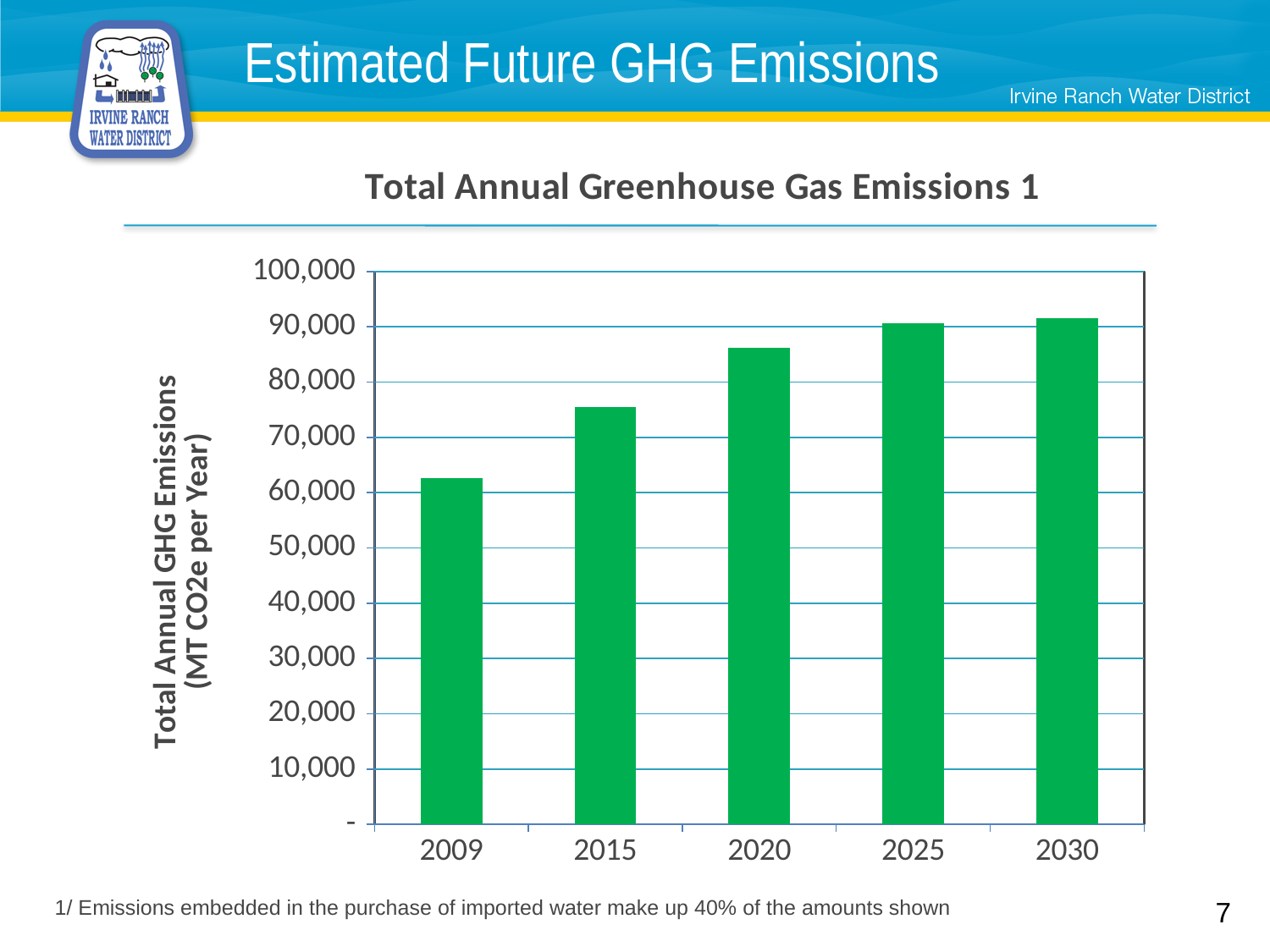
Is the value for 2020 greater or less than 80,000? greater Which year has the lowest total annual GHG emissions? 2009 Is the value for 2025 greater or less than 80,000? greater Which year has the larger emissions value, 2015 or 2020? 2020 How many years are plotted on the chart? 5 Do the emissions values rise or fall from 2009 to 2030? Rise What is the title of the chart? Total Annual Greenhouse Gas Emissions 1 What unit is given on the y-axis label? MT CO2e per Year What kind of chart is shown on the slide? Bar chart Is the value for 2015 greater or less than 70,000? greater